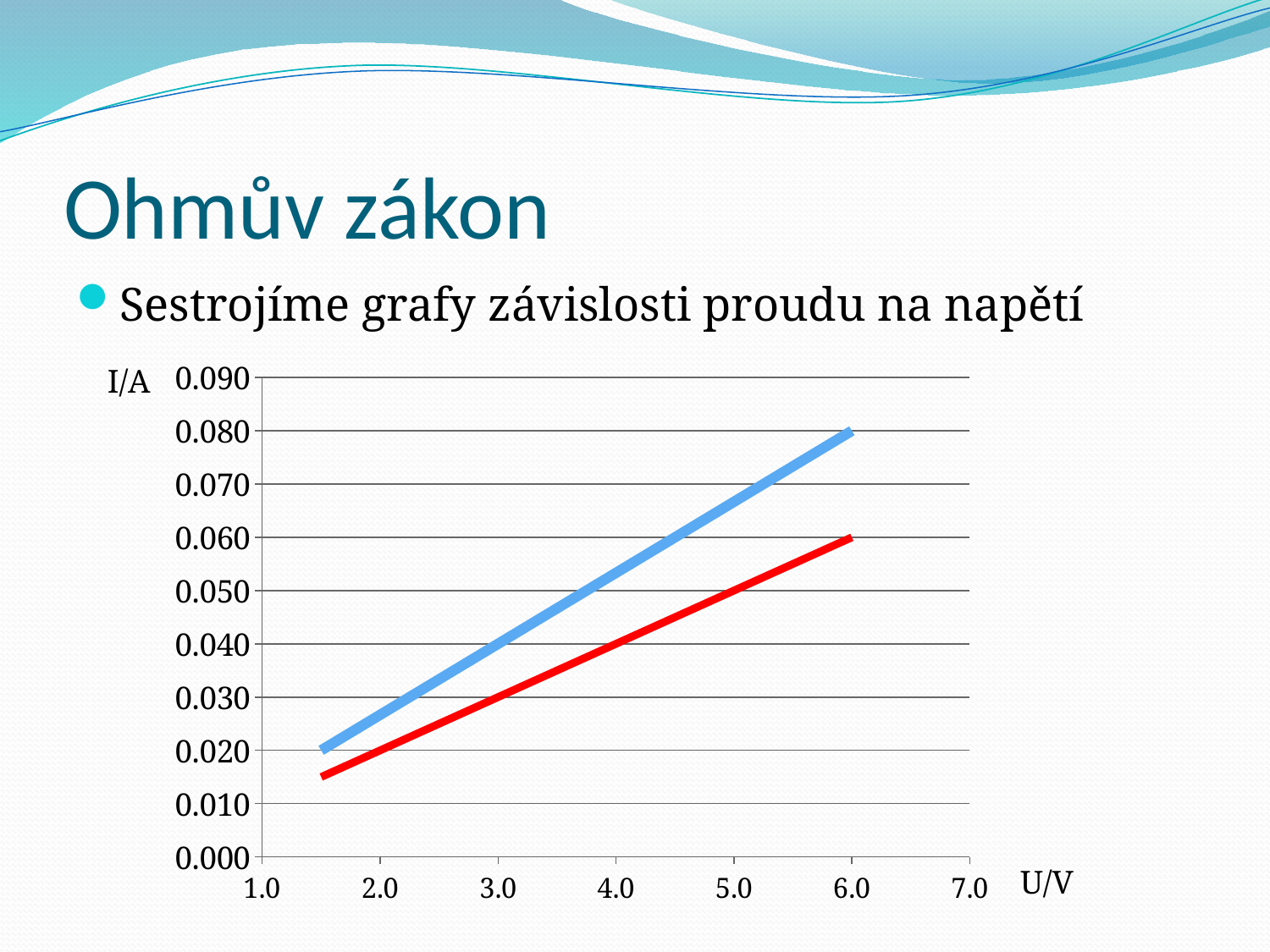
How many lines are plotted on the chart? 2 Is the value of the blue line at U = 5.0 V greater or less than 0.060? greater What is the label of the horizontal axis of the chart? U/V What is the value of the red line at U = 6.0 V? 0.060 Which line is higher at U = 6.0 V, the blue line or the red line? blue What is the label of the vertical axis of the chart? I/A Do the plotted values rise or fall as U/V increases along the x axis? rise Is the value of the red line at U = 4.0 V greater or less than 0.050? less Is the value of the red line at U = 6.0 V greater or less than 0.070? less What is the value of the blue line at U = 6.0 V? 0.080 What kind of chart is shown on the slide? line chart